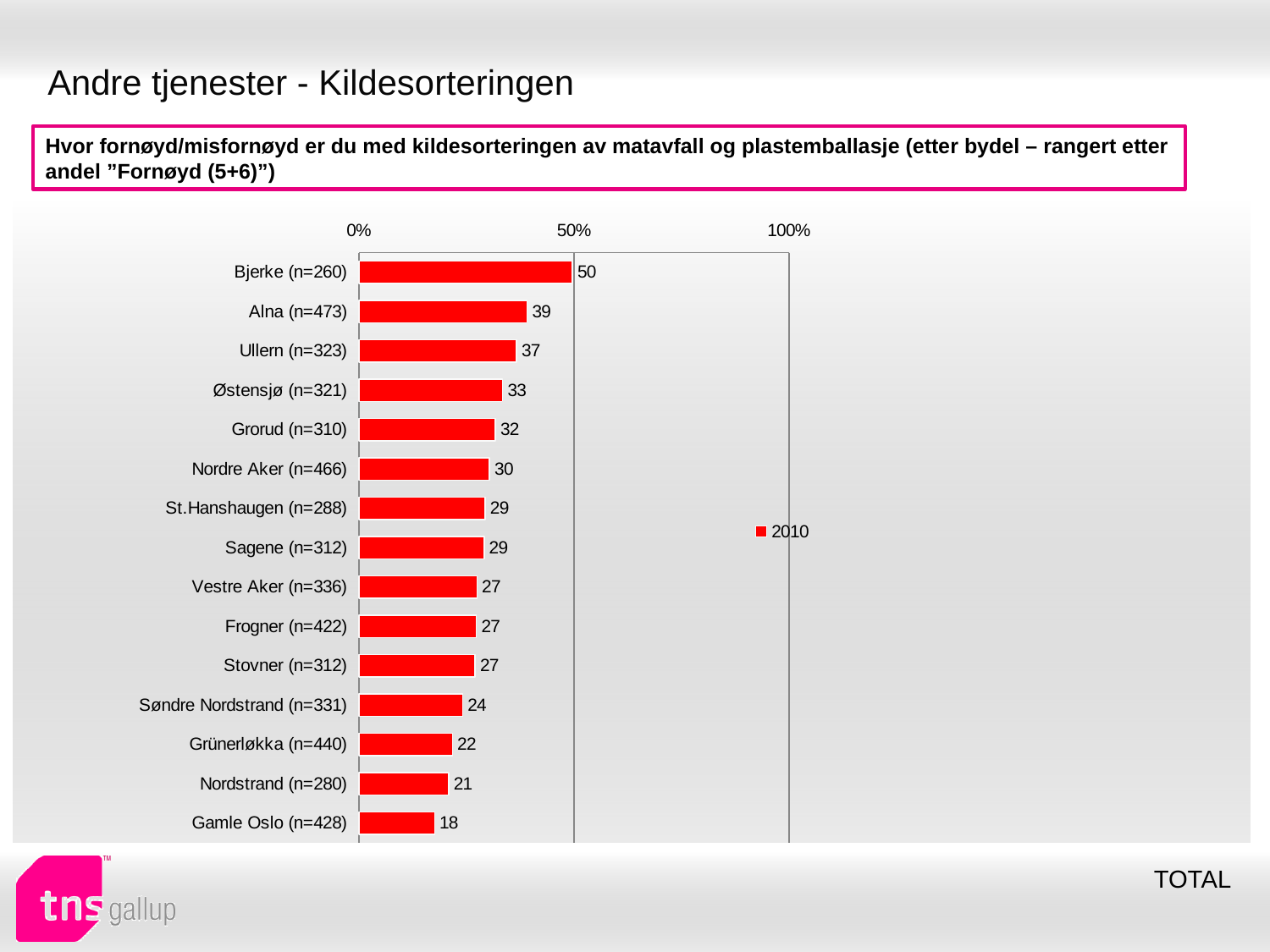
How many districts are shown in the chart? 15 What kind of chart is shown on the slide? bar chart Is the value for Bjerke (n=260) greater or less than 100%? less Which district has the highest value? Bjerke (n=260) What is the value for Grünerløkka (n=440)? 22 Which is larger, the value for Østensjø (n=321) or the value for Søndre Nordstrand (n=331)? Østensjø (n=321) What is the value for Nordre Aker (n=466)? 30 How many series does the legend list? 1 Which district has the lowest value? Gamle Oslo (n=428) What is the difference between the values for Ullern (n=323) and Gamle Oslo (n=428)? 19 What is the value for Bjerke (n=260)? 50 What is the difference between the values for Bjerke (n=260) and Alna (n=473)? 11